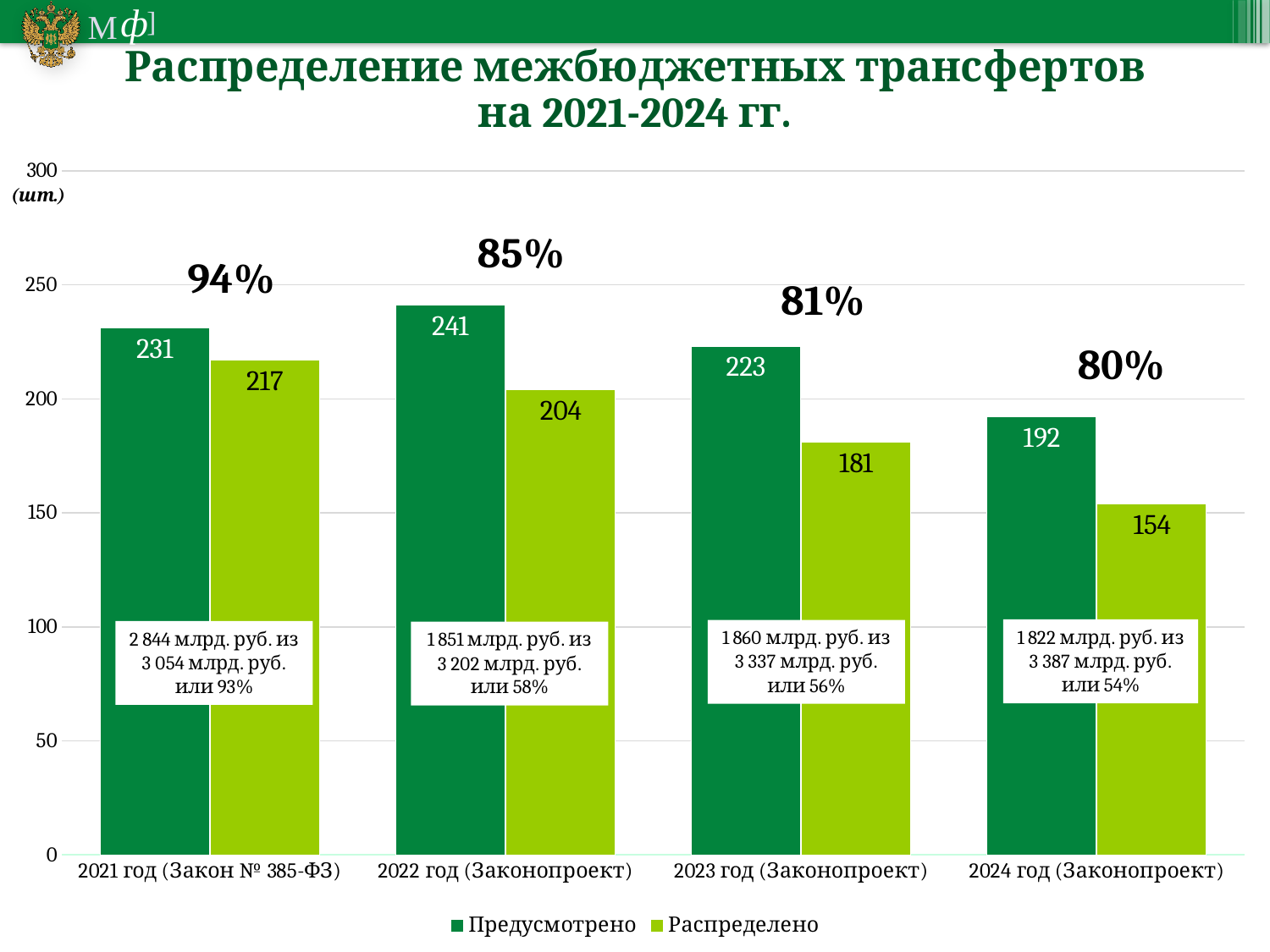
What kind of chart is shown on the slide? Bar chart Which is larger: Распределено for 2022 год or Предусмотрено for 2024 год? Распределено for 2022 год What is the value of Предусмотрено for 2022 год (Законопроект)? 241 How many series does the legend list? 2 Do the Распределено values rise or fall from 2021 to 2024? Fall What is the difference between Предусмотрено and Распределено for 2023 год (Законопроект)? 42 Which year has the highest Предусмотрено value? 2022 год (Законопроект) What is the value of Распределено for 2024 год (Законопроект)? 154 Which year has the lowest Распределено value? 2024 год (Законопроект) What percentage is shown above the bars for 2023 год (Законопроект)? 81% How many years (categories) are shown on the x axis? 4 What is the value of Распределено for 2021 год (Закон № 385-ФЗ)? 217